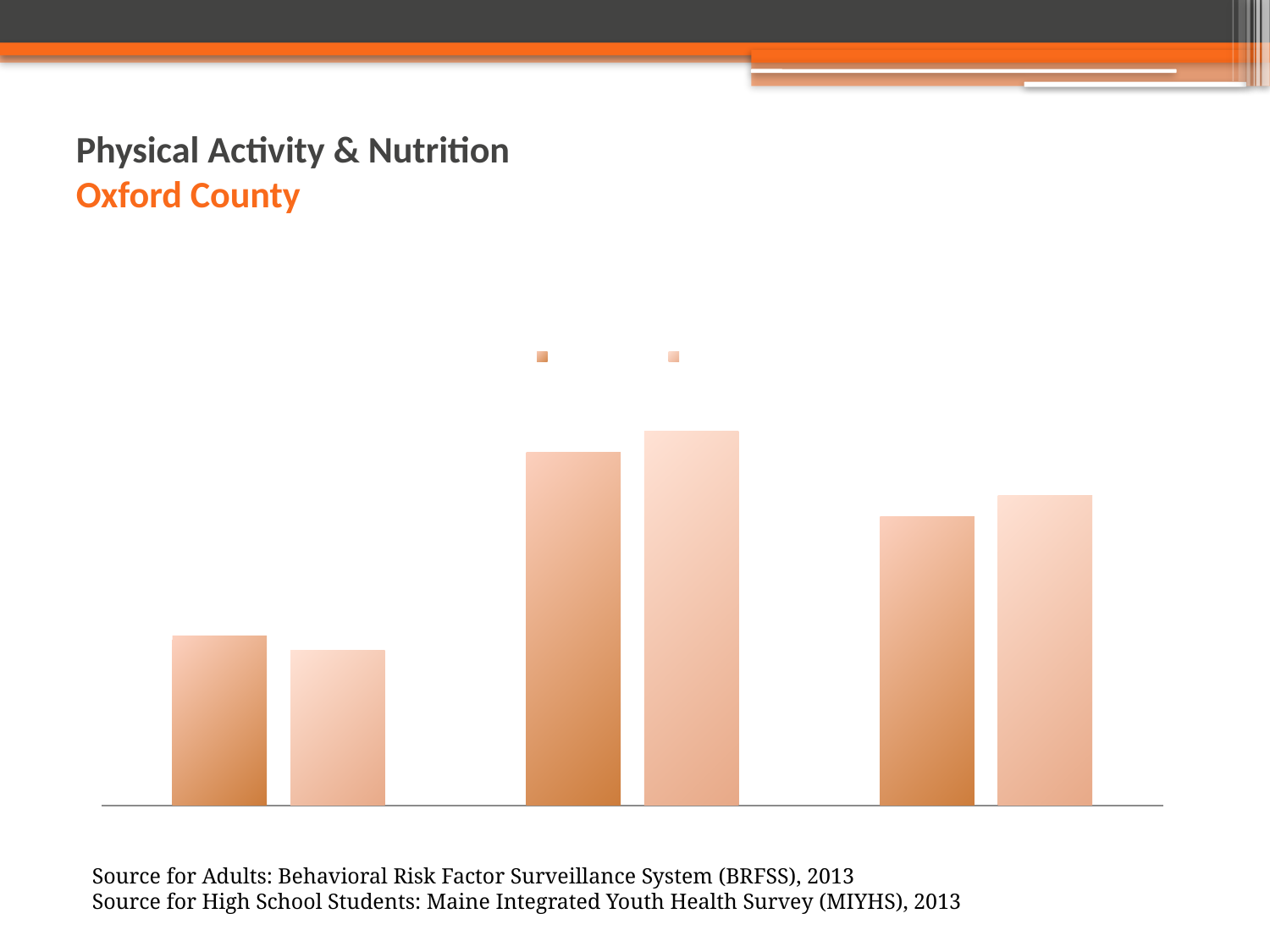
Are the bars in the chart vertical or horizontal? vertical In the leftmost group, which bar is taller: the darker orange bar or the lighter orange bar? the darker orange bar What kind of chart is shown on the slide? bar chart What colour are the bars in the chart? orange Which group of bars is the tallest: the left, middle, or right group? middle In the rightmost group, which bar is taller: the darker orange bar or the lighter orange bar? the lighter orange bar How many series does the legend show? 2 How many groups of bars does the chart contain? 3 How many bars are plotted in the chart? 6 Which group of bars is the shortest: the left, middle, or right group? left In the middle group, which bar is taller: the darker orange bar or the lighter orange bar? the lighter orange bar